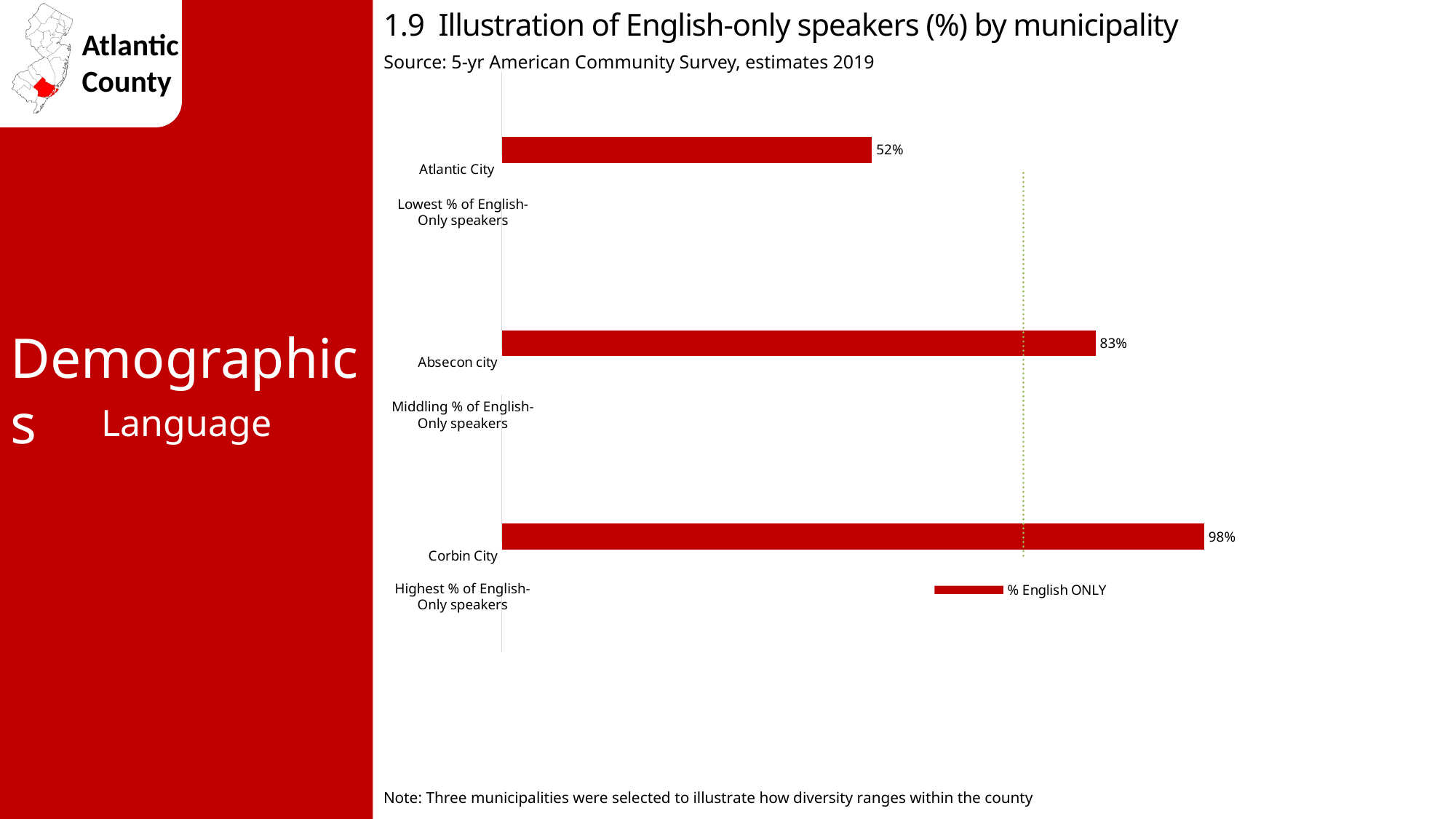
What is the difference in percentage points between Corbin City and Atlantic City? 46 Which has a higher percentage of English-only speakers, Absecon city or Atlantic City? Absecon city What is the legend entry for the series shown in the chart? % English ONLY What is the difference in percentage points between Absecon city and Atlantic City? 31 Which municipality has the lowest percentage of English-only speakers? Atlantic City Which municipality has the highest percentage of English-only speakers? Corbin City What kind of chart is shown on the slide? Bar chart How many municipalities are shown in the chart? 3 What is the percentage of English-only speakers in Atlantic City? 52% What is the percentage of English-only speakers in Absecon city? 83% What is the percentage of English-only speakers in Corbin City? 98% How many series does the legend list? 1